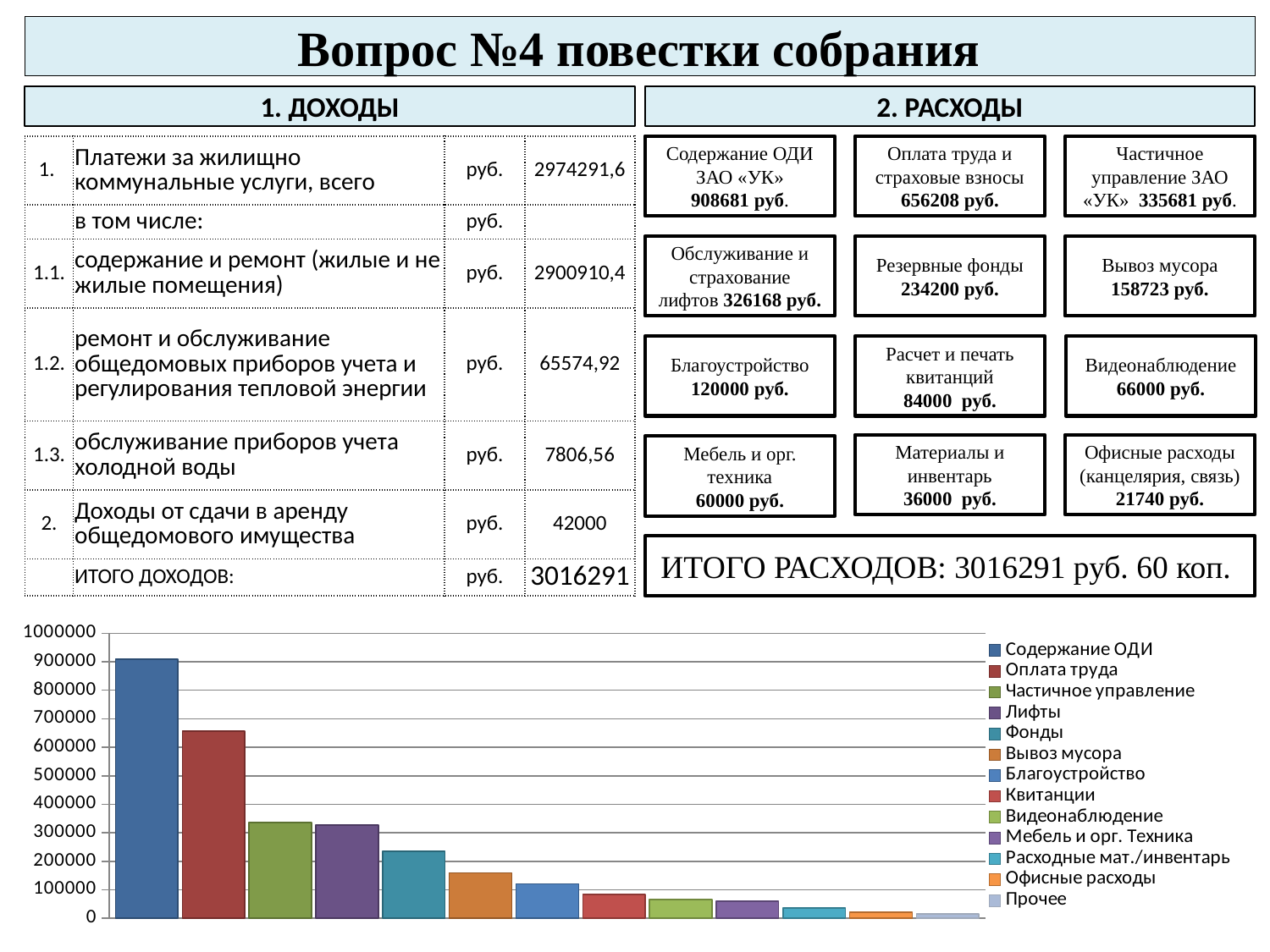
Is the bar for Оплата труда greater or less than 600000? greater Which bar is taller: Фонды or Благоустройство? Фонды Do the bar heights rise or fall from left to right across the chart? fall Which bar is taller: Оплата труда or Частичное управление? Оплата труда How many bars are plotted in the bar chart? 13 Is the bar for Фонды greater or less than 200000? greater Which series has the shortest bar in the chart? Прочее Is the bar for Вывоз мусора greater or less than 200000? less Which series has the tallest bar in the chart? Содержание ОДИ How many series does the legend of the bar chart list? 13 What kind of chart is shown at the bottom of the slide? bar chart